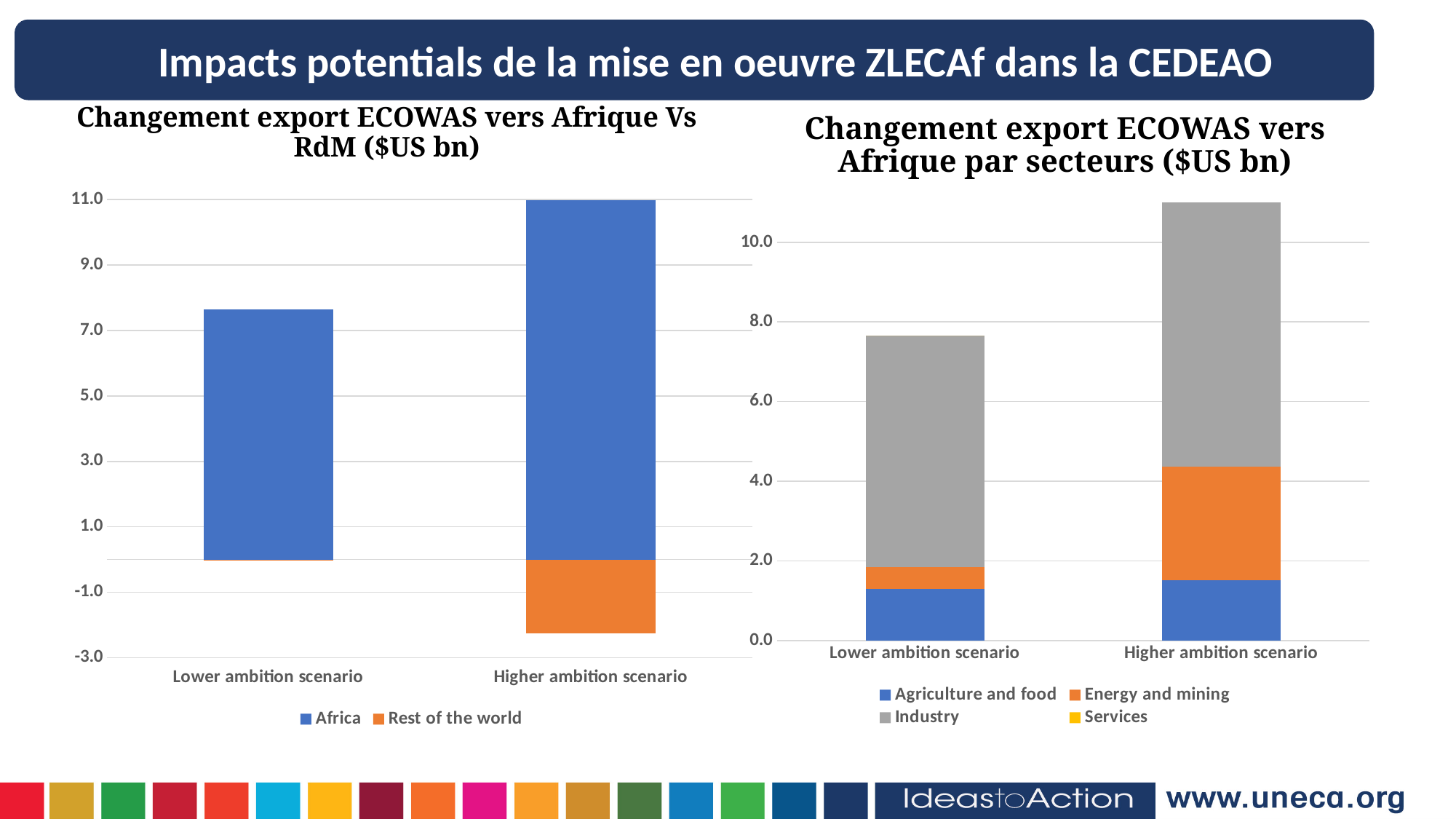
In the right chart, 'Changement export ECOWAS vers Afrique par secteurs ($US bn)', which sector makes up the largest segment of the Lower ambition scenario bar? Industry In the right chart, 'Changement export ECOWAS vers Afrique par secteurs ($US bn)', which scenario has the taller stacked bar? Higher ambition scenario In the left chart, 'Changement export ECOWAS vers Afrique Vs RdM ($US bn)', is the Africa value for the Higher ambition scenario greater or less than 9.0? greater In the left chart, 'Changement export ECOWAS vers Afrique Vs RdM ($US bn)', what kind of chart is shown? bar chart In the right chart, 'Changement export ECOWAS vers Afrique par secteurs ($US bn)', how many series does the legend list? 4 In the right chart, 'Changement export ECOWAS vers Afrique par secteurs ($US bn)', which colour represents Industry in the legend? grey In the right chart, 'Changement export ECOWAS vers Afrique par secteurs ($US bn)', is the total for the Higher ambition scenario greater or less than 10.0? greater In the left chart, 'Changement export ECOWAS vers Afrique Vs RdM ($US bn)', which scenario has the larger Africa value? Higher ambition scenario In the left chart, 'Changement export ECOWAS vers Afrique Vs RdM ($US bn)', is the Africa value for the Lower ambition scenario greater or less than 7.0? greater In the left chart, 'Changement export ECOWAS vers Afrique Vs RdM ($US bn)', how many series does the legend list? 2 In the right chart, 'Changement export ECOWAS vers Afrique par secteurs ($US bn)', how many scenario categories are shown on the x axis? 2